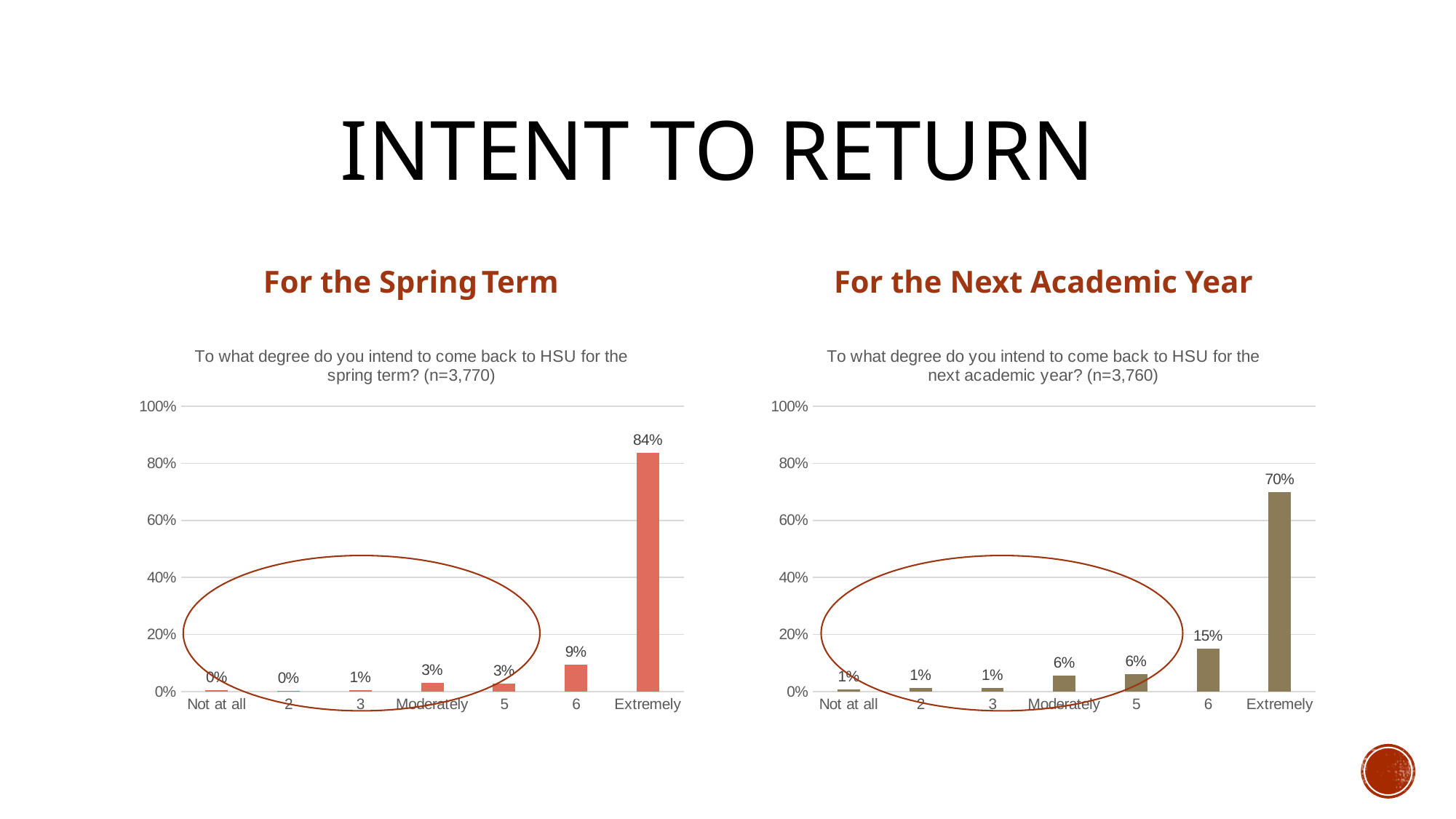
How many categories are shown on the x axis of the 'For the Spring Term' chart? 7 What kind of chart is the 'For the Next Academic Year' chart? Bar chart In the 'For the Spring Term' chart, which category has the highest value? Extremely What is the difference between the Extremely value in the 'For the Spring Term' chart and the Extremely value in the 'For the Next Academic Year' chart? 14% What is the sample size (n) shown in the title of the 'For the Spring Term' chart? 3,770 In the 'For the Spring Term' chart, which is larger, the value for 6 or the value for 5? 6 In the 'For the Spring Term' chart, what is the value for Moderately? 3% In the 'For the Next Academic Year' chart, what is the difference between the values for Extremely and 6? 55% In the 'For the Next Academic Year' chart, what is the value for Extremely? 70% In the 'For the Next Academic Year' chart, what is the value for 6? 15% In the 'For the Spring Term' chart, what is the value for Extremely? 84% In the 'For the Next Academic Year' chart, is the value for Extremely greater or less than 60%? greater